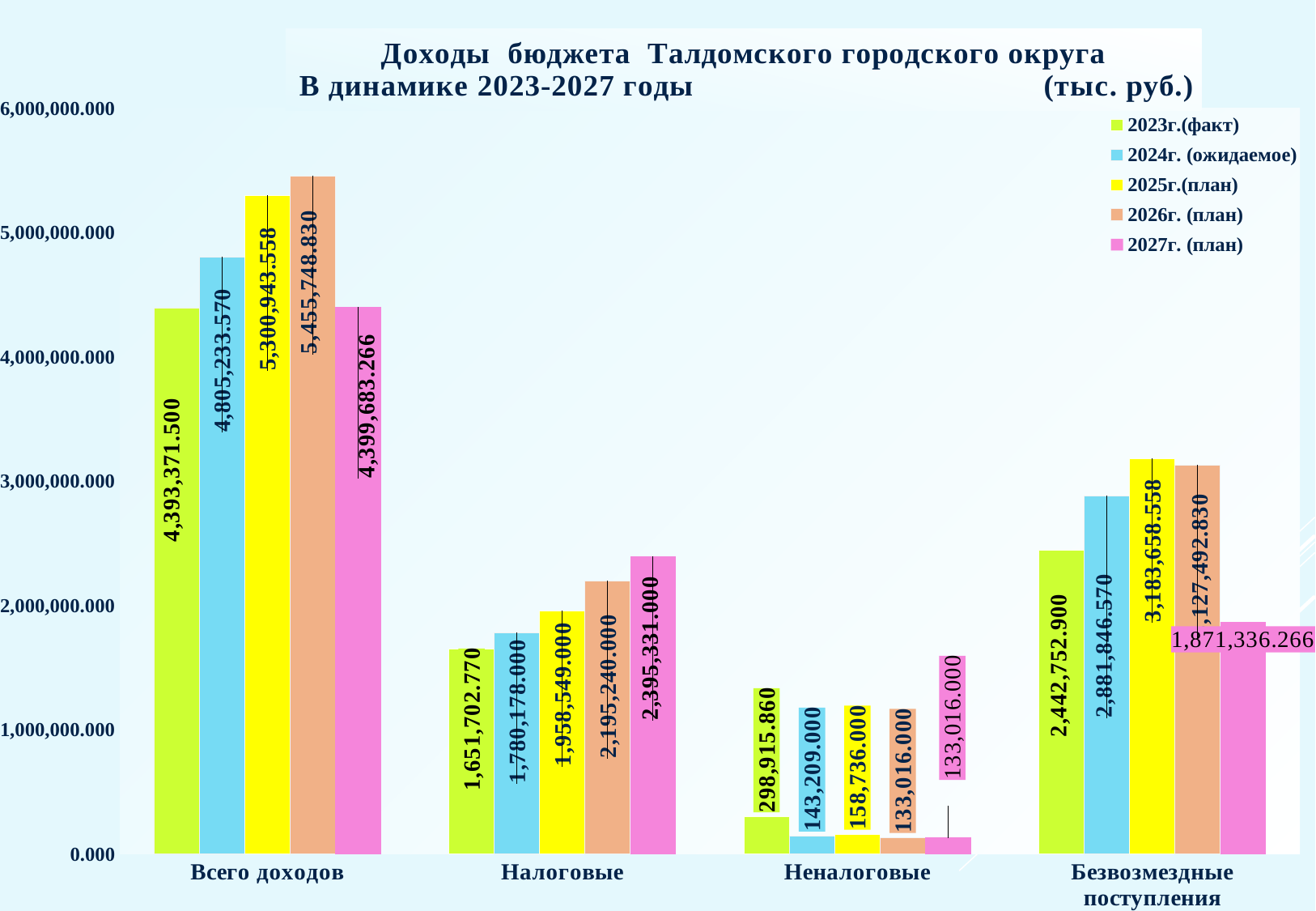
What is the difference between the 2027г. (план) and 2023г.(факт) values in the Налоговые category? 743,628.230 Do the values in the Налоговые category rise or fall from 2023 to 2027? rise How many series does the legend list? 5 Which year has the lowest value in the Безвозмездные поступления category? 2027г. (план) What is the value for 2023г.(факт) in the Неналоговые category? 298,915.860 What is the value for 2027г. (план) in the Налоговые category? 2,395,331.000 In the Безвозмездные поступления category, which is larger: the 2025г.(план) value or the 2026г. (план) value? 2025г.(план) What is the value for 2023г.(факт) in the Всего доходов category? 4,393,371.500 How many categories are shown on the x axis? 4 Which year has the highest value in the Всего доходов category? 2026г. (план) Is the value for 2024г. (ожидаемое) in the Безвозмездные поступления category greater or less than 2,000,000.000? greater What is the difference between the 2026г. (план) and 2025г.(план) values in the Всего доходов category? 154,805.272